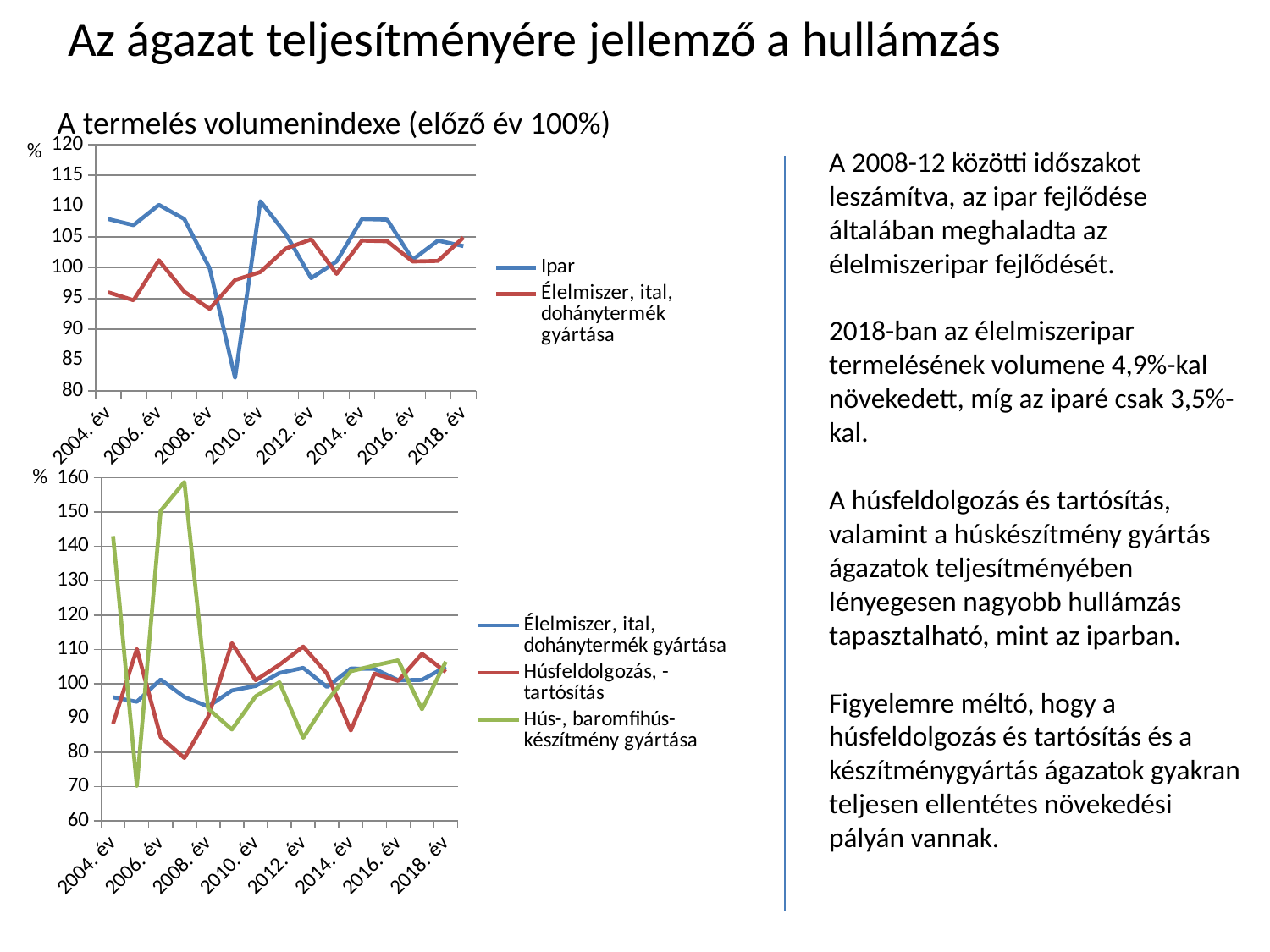
What kind of chart is the top chart on the slide? line chart In the top chart, what colour is the Ipar line? blue What is the title shown above the top chart? A termelés volumenindexe (előző év 100%) How many series does the legend of the bottom chart list? 3 In the top chart, does the Ipar line rise or fall between 2006. év and 2008. év? fall In the top chart, which series has the higher value in 2004. év, Ipar or Élelmiszer, ital, dohánytermék gyártása? Ipar In the bottom chart, which series reaches the highest value? Hús-, baromfihús-készítmény gyártása In the top chart, is the lowest value of the Ipar line greater or less than 85? less How many series does the legend of the top chart list? 2 In the bottom chart, is the highest value of the Hús-, baromfihús-készítmény gyártása line greater or less than 150? greater In the bottom chart, which series has the higher value in 2004. év, Húsfeldolgozás, -tartósítás or Hús-, baromfihús-készítmény gyártása? Hús-, baromfihús-készítmény gyártása In the top chart, is the value for Ipar in 2004. év greater or less than 105? greater